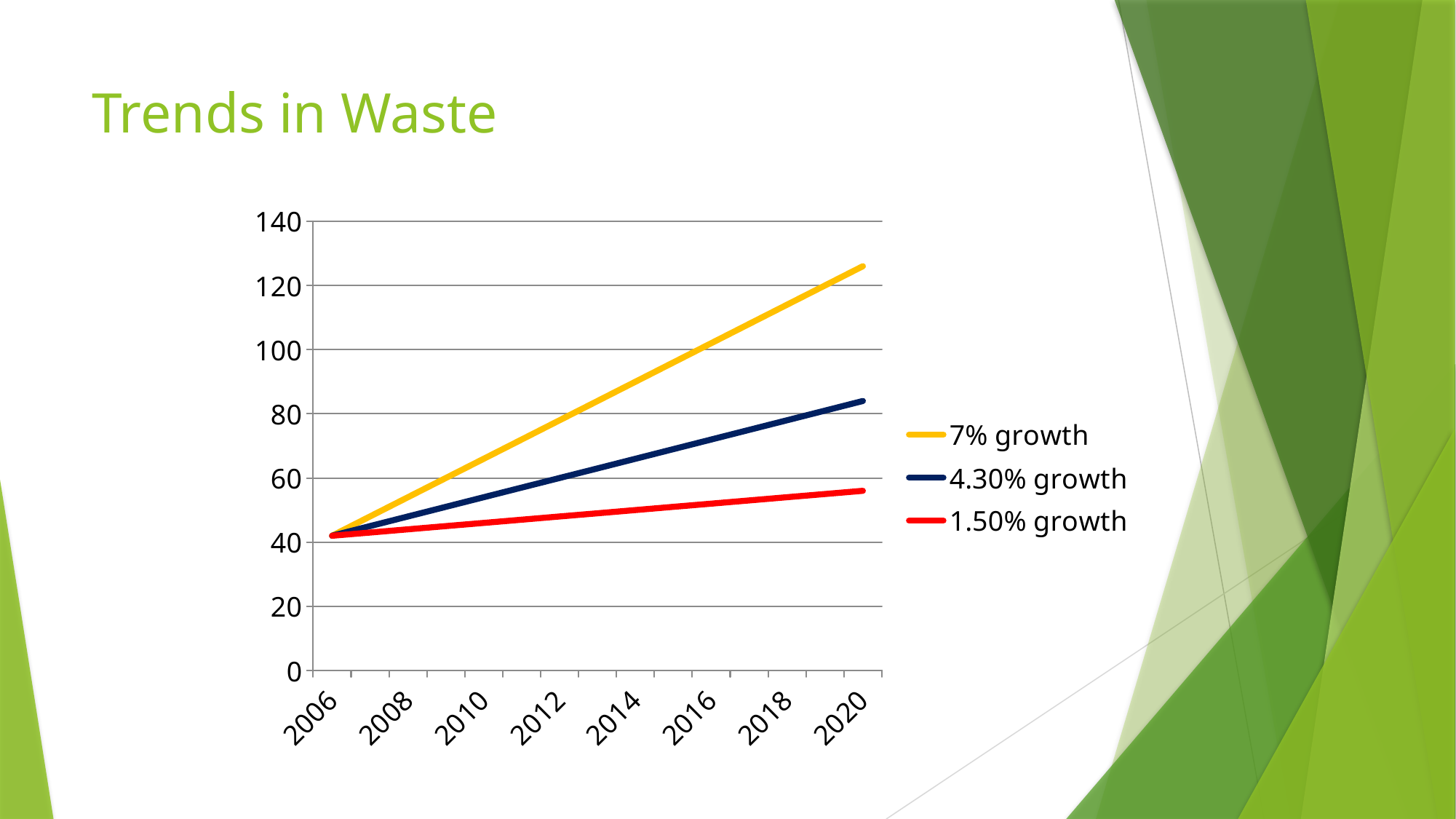
What colour is the line for the 1.50% growth series? red Do the values of the 7% growth series rise or fall from 2006 to 2020? rise Which series has the highest value in 2020? 7% growth Which series has the lowest value in 2020? 1.50% growth What is the title of the slide containing the chart? Trends in Waste Is the value of the 1.50% growth series in 2020 greater or less than 60? less Is the value of the 4.30% growth series in 2020 greater or less than 100? less How many series does the legend list? 3 Is the value of the 7% growth series in 2012 greater or less than 60? greater What kind of chart is shown on the slide? line chart In 2020, which is larger: the 4.30% growth series or the 1.50% growth series? 4.30% growth